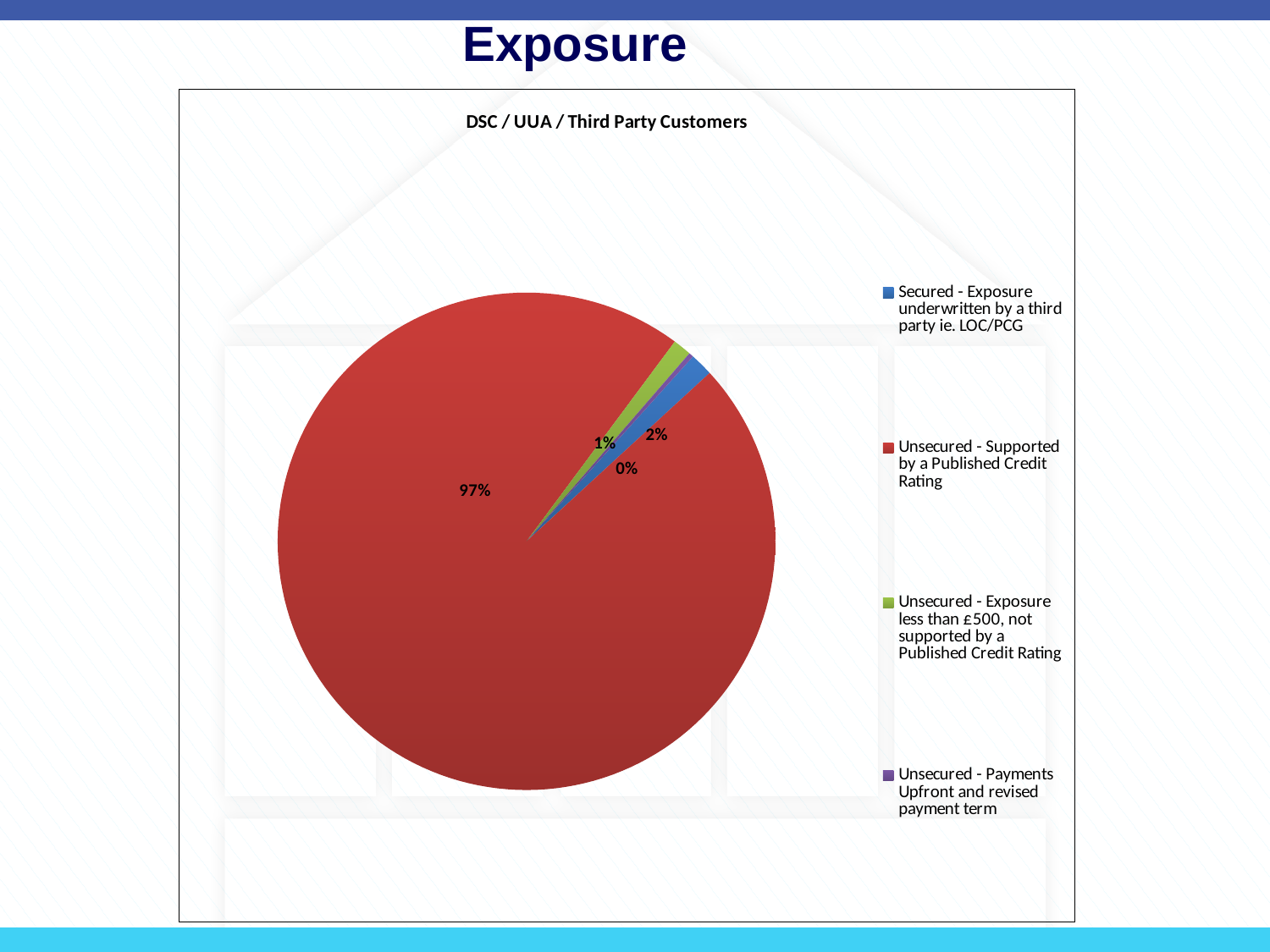
What is the title of the chart? DSC / UUA / Third Party Customers What colour is the slice for 'Unsecured - Supported by a Published Credit Rating'? red What kind of chart is shown on the slide? pie chart What is the difference in percentage points between the 'Unsecured - Supported by a Published Credit Rating' slice and the 'Secured - Exposure underwritten by a third party ie. LOC/PCG' slice? 95 How many categories does the legend list? 4 Which category has the smallest slice of the pie? Unsecured - Payments Upfront and revised payment term What share of the pie is 'Unsecured - Payments Upfront and revised payment term'? 0% Which category has the largest slice of the pie? Unsecured - Supported by a Published Credit Rating Which is larger: the 'Secured - Exposure underwritten by a third party ie. LOC/PCG' slice or the 'Unsecured - Exposure less than £500, not supported by a Published Credit Rating' slice? Secured - Exposure underwritten by a third party ie. LOC/PCG What share of the pie is 'Unsecured - Exposure less than £500, not supported by a Published Credit Rating'? 1% What share of the pie is 'Secured - Exposure underwritten by a third party ie. LOC/PCG'? 2%